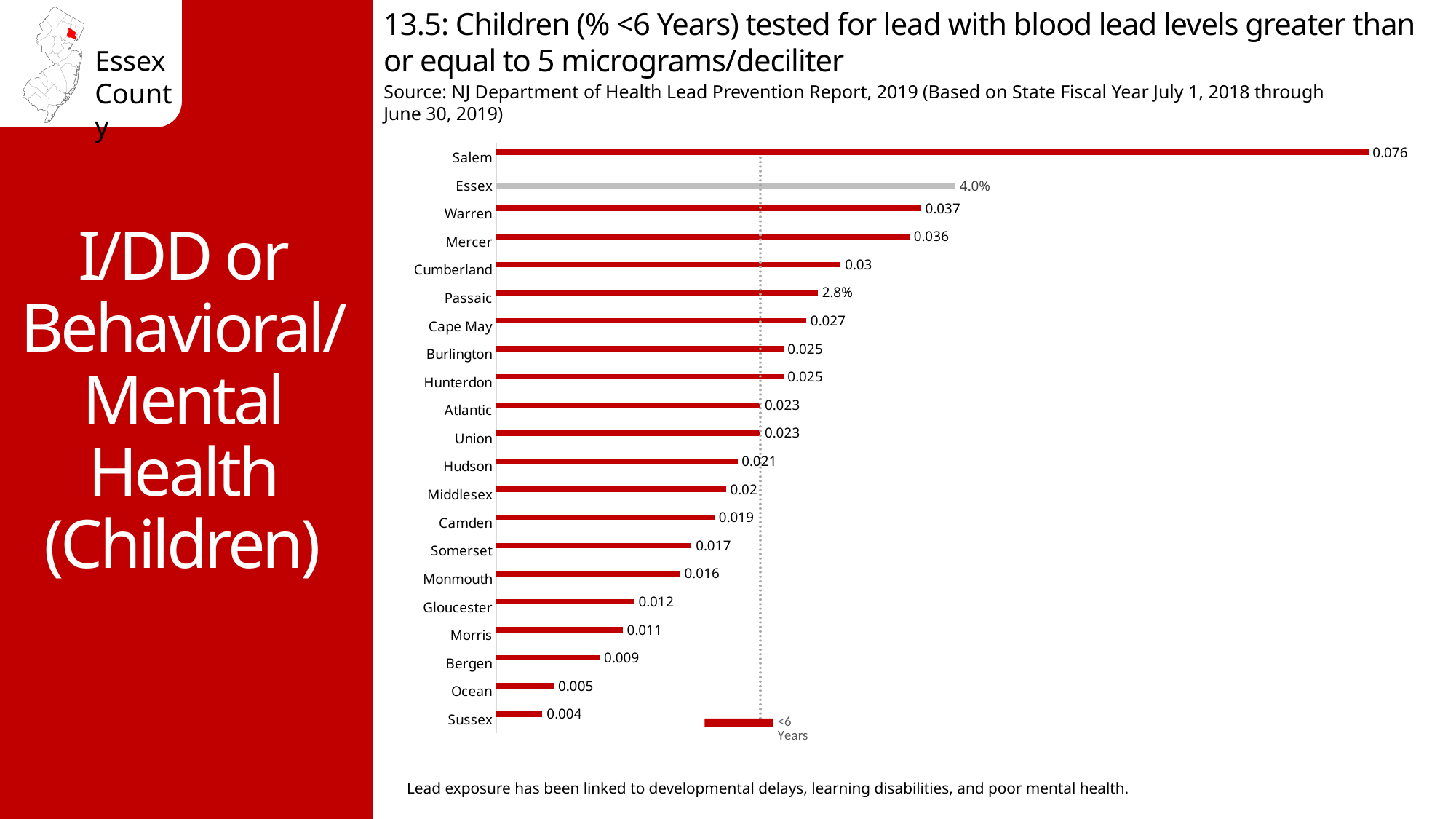
What is the difference between the values for Warren and Mercer? 0.001 What is the difference between the values for Salem and Sussex? 0.072 What is the value shown for Bergen? 0.009 What is the value shown for Salem? 0.076 What is the value shown for Essex? 4.0% What kind of chart is shown on the slide? Bar chart How many counties are shown in the chart? 21 What is the legend entry shown for the chart? <6 Years What is the value shown for Passaic? 2.8% Which county has the highest value in the chart? Salem Which has a larger value, Cumberland or Camden? Cumberland Which county has the lowest value in the chart? Sussex